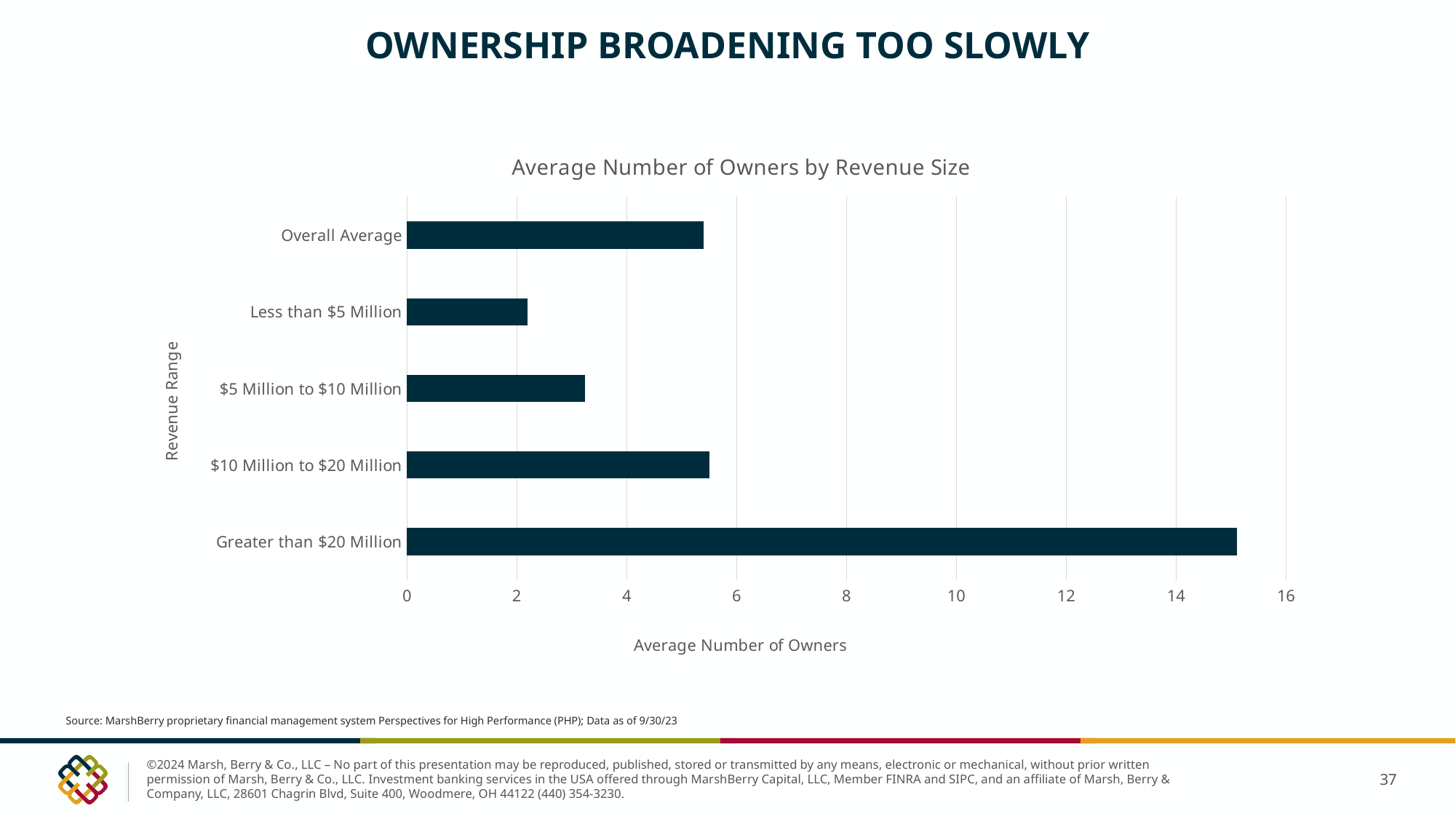
How many revenue range categories are plotted in the chart? 5 What is the title of the chart? Average Number of Owners by Revenue Size Is the average number of owners for $10 Million to $20 Million greater or less than 4? greater Is the average number of owners for Less than $5 Million greater or less than 4? less Is the average number of owners for $5 Million to $10 Million greater or less than 4? less Which revenue range has the highest average number of owners? Greater than $20 Million What type of chart is shown on the slide? Bar chart What is the label on the horizontal axis of the chart? Average Number of Owners Which revenue range has the lowest average number of owners? Less than $5 Million Which has a higher average number of owners: Less than $5 Million or $5 Million to $10 Million? $5 Million to $10 Million